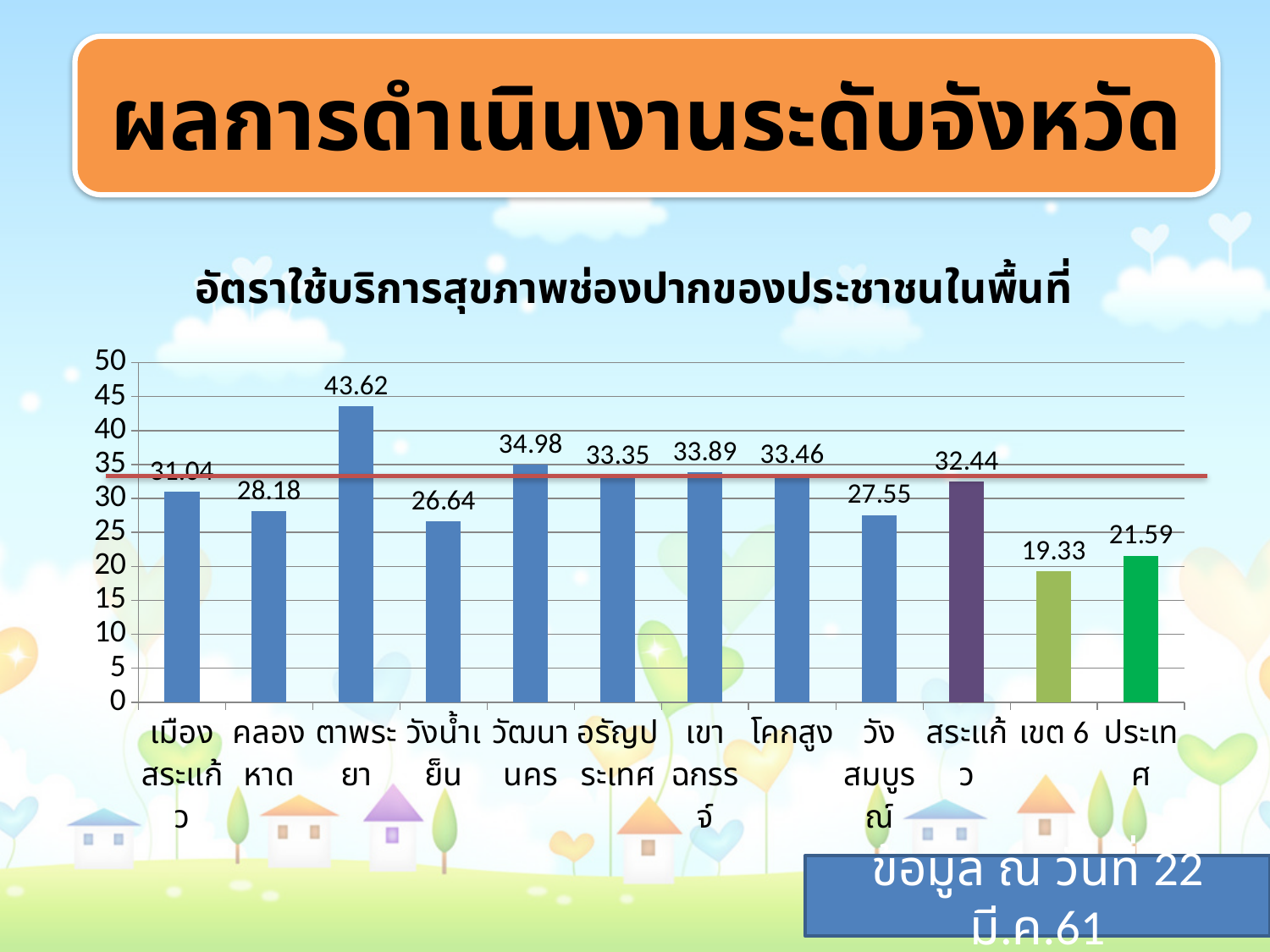
What is the value for เขต 6? 19.33 What is the value for ตาพระยา? 43.62 Which is larger, the value for วัฒนานคร or the value for คลองหาด? วัฒนานคร How many categories are shown on the x axis? 12 What type of chart is shown on the slide? bar chart What is the value for สระแก้ว? 32.44 Is the value for วังสมบูรณ์ greater or less than 30? less Which category has the highest value? ตาพระยา What is the difference between the values for ตาพระยา and วังน้ำเย็น? 16.98 What is the value for ประเทศ? 21.59 What is the title of the chart? อัตราใช้บริการสุขภาพช่องปากของประชาชนในพื้นที่ Which category has the lowest value? เขต 6